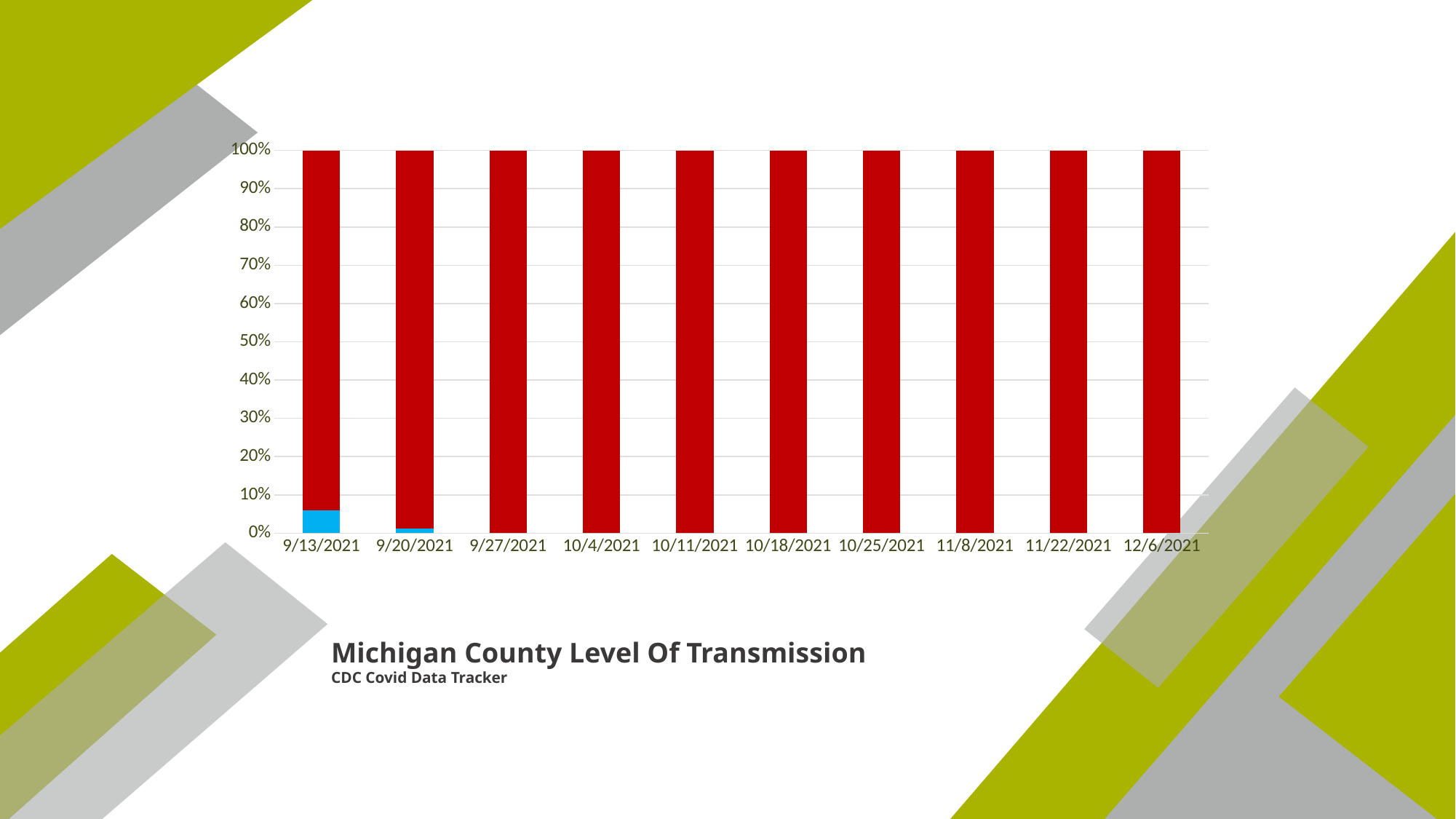
Is the blue segment for 9/13/2021 greater or less than 10%? less What data source is cited under the chart title? CDC Covid Data Tracker Is the red segment for 9/27/2021 greater or less than 90%? greater Which date has the largest blue segment? 9/13/2021 How many bars include a visible blue segment? 2 What is the title printed below the chart? Michigan County Level Of Transmission What is the total height of the stacked bar for 10/4/2021? 100% What kind of chart is shown on the slide? Stacked bar chart Does the blue segment rise or fall from 9/13/2021 to 9/20/2021? fall Which has the larger blue segment, 9/13/2021 or 9/20/2021? 9/13/2021 How many dates are shown along the x axis of the chart? 10 Is the blue segment for 9/20/2021 greater or less than 10%? less